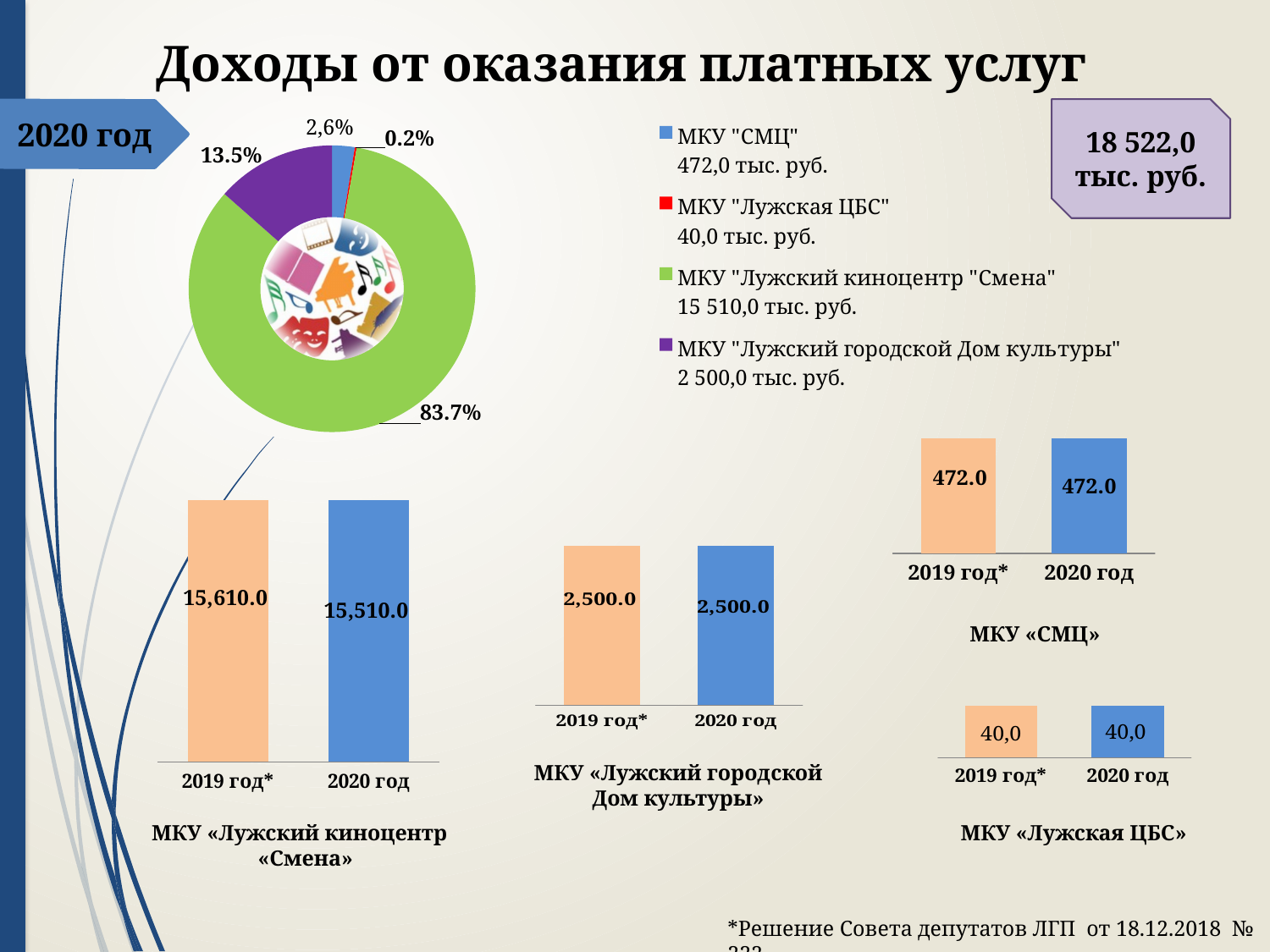
In the bar chart for МКУ «Лужская ЦБС», what is the value for 2019 год*? 40,0 In the pie chart, what share does МКУ "Лужский городской Дом культуры" hold? 13.5% In the pie chart, what share does МКУ "Лужский киноцентр "Смена" hold? 83.7% What kind of chart is used for МКУ «СМЦ»? bar chart How many bars are in the chart for МКУ «СМЦ»? 2 In the bar chart for МКУ «Лужский киноцентр «Смена», what is the value for 2019 год*? 15,610.0 In the bar chart for МКУ «Лужский киноцентр «Смена», what is the value for 2020 год? 15,510.0 How many entries does the pie chart legend list? 4 According to the pie chart legend, what is the value for МКУ "СМЦ"? 472,0 тыс. руб. In the bar chart for МКУ «Лужский городской Дом культуры», what is the value for 2020 год? 2,500.0 In the pie chart, which organisation has the smallest slice? МКУ "Лужская ЦБС" In the bar chart for МКУ «Лужский киноцентр «Смена», what is the difference between the 2019 год* and 2020 год values? 100.0